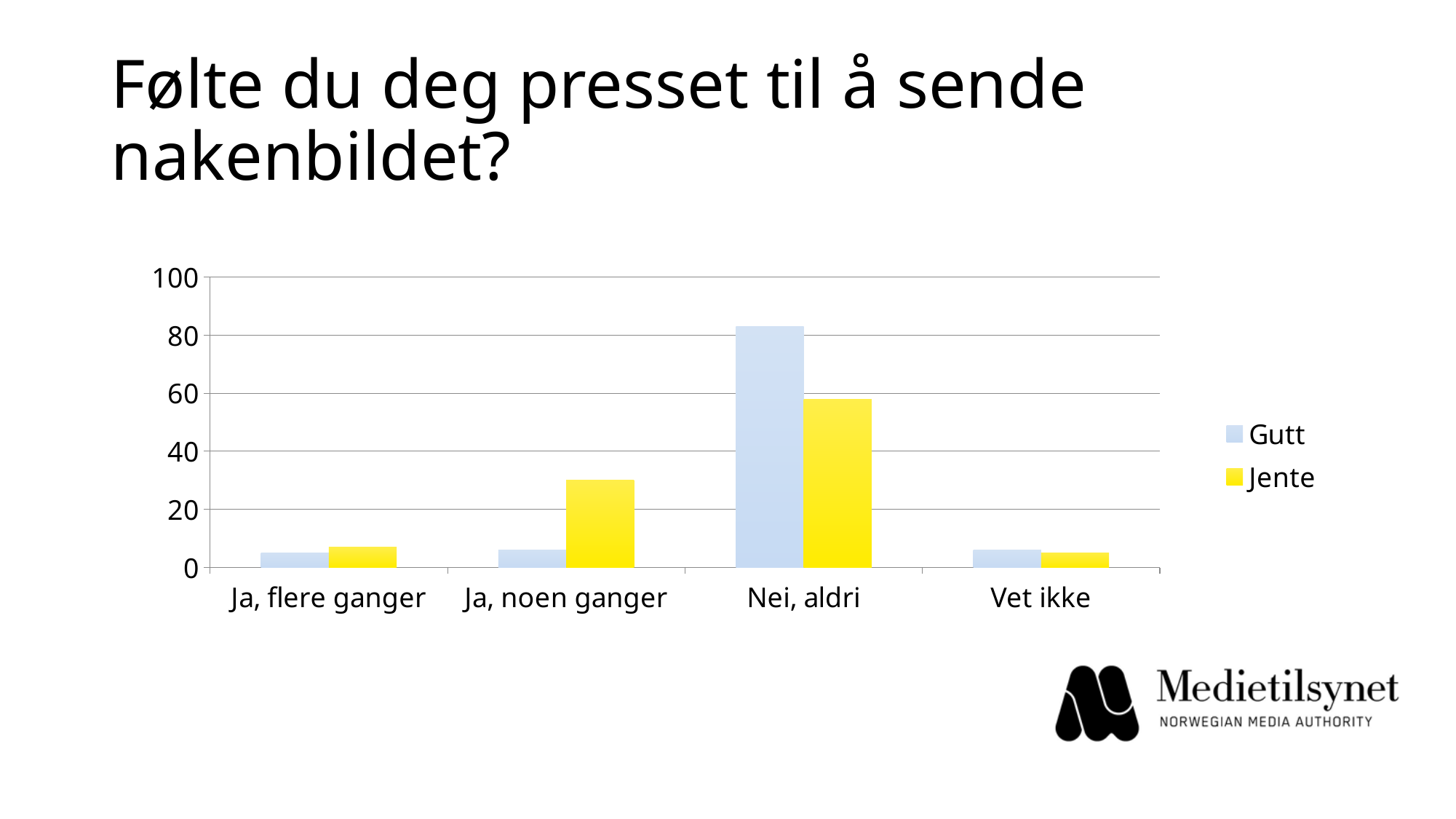
In the category Ja, noen ganger, which series has the larger value, Gutt or Jente? Jente In the category Nei, aldri, which series has the larger value, Gutt or Jente? Gutt What kind of chart is shown on the slide? bar chart How many categories are shown on the x axis of the chart? 4 Which category has the highest value for Gutt? Nei, aldri Is the value for Jente in the category Nei, aldri greater or less than 60? less Is the value for Gutt in the category Ja, noen ganger greater or less than 20? less How many series does the chart's legend list? 2 Which category has the highest value for Jente? Nei, aldri Is the value for Gutt in the category Nei, aldri greater or less than 80? greater What colour are the bars for the Jente series? yellow